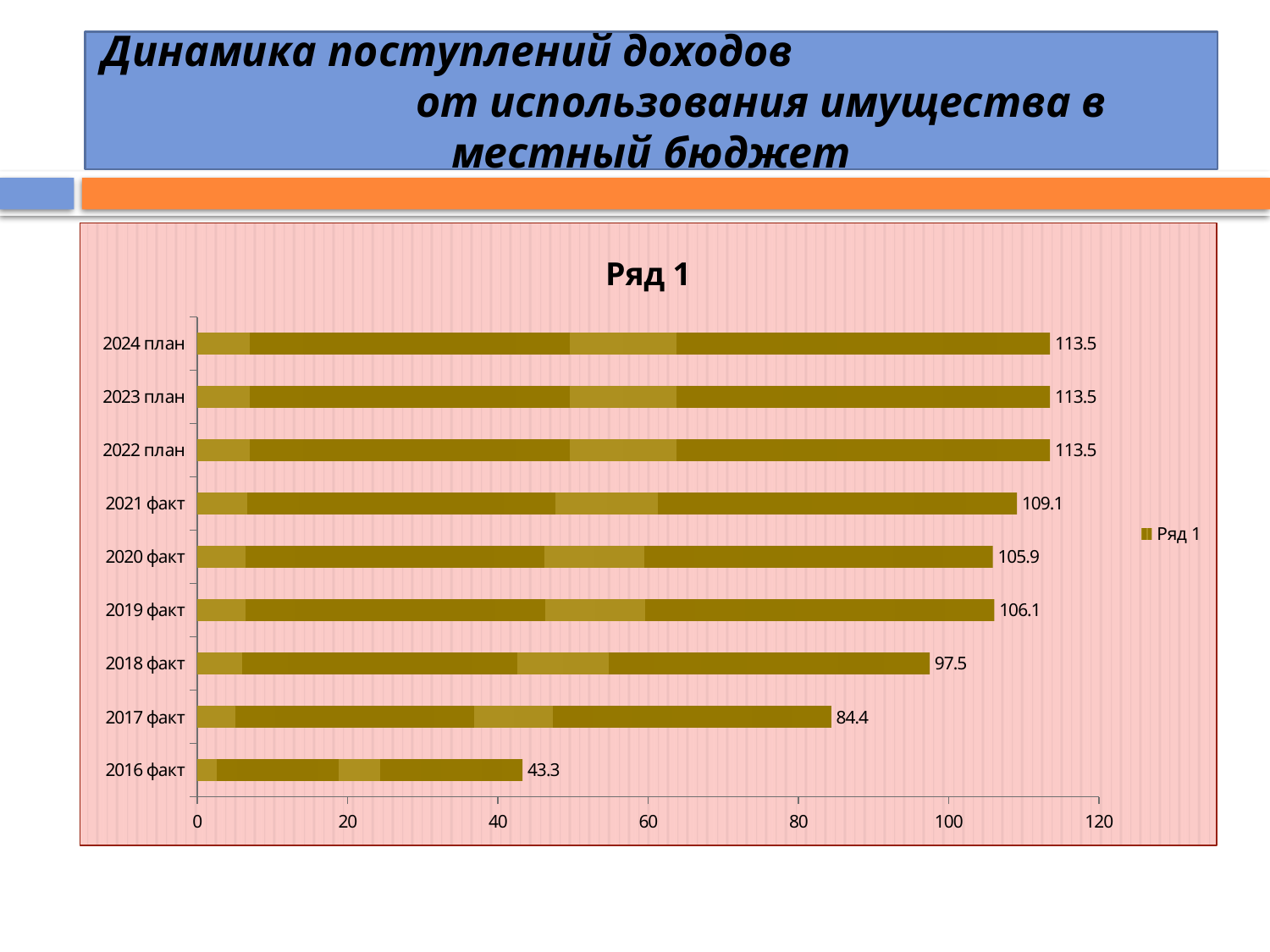
What is the value for 2016 факт? 43.3 How many series does the legend list? 1 What is the difference between the values for 2018 факт and 2017 факт? 13.1 How many categories are shown on the chart? 9 What is the difference between the values for 2021 факт and 2016 факт? 65.8 What is the value for 2024 план? 113.5 What kind of chart is shown on the slide? bar chart Which category has the lowest value? 2016 факт What is the value for 2018 факт? 97.5 Is the value for 2017 факт greater or less than 100? less What is the value for 2021 факт? 109.1 Which is larger, the value for 2017 факт or the value for 2018 факт? 2018 факт